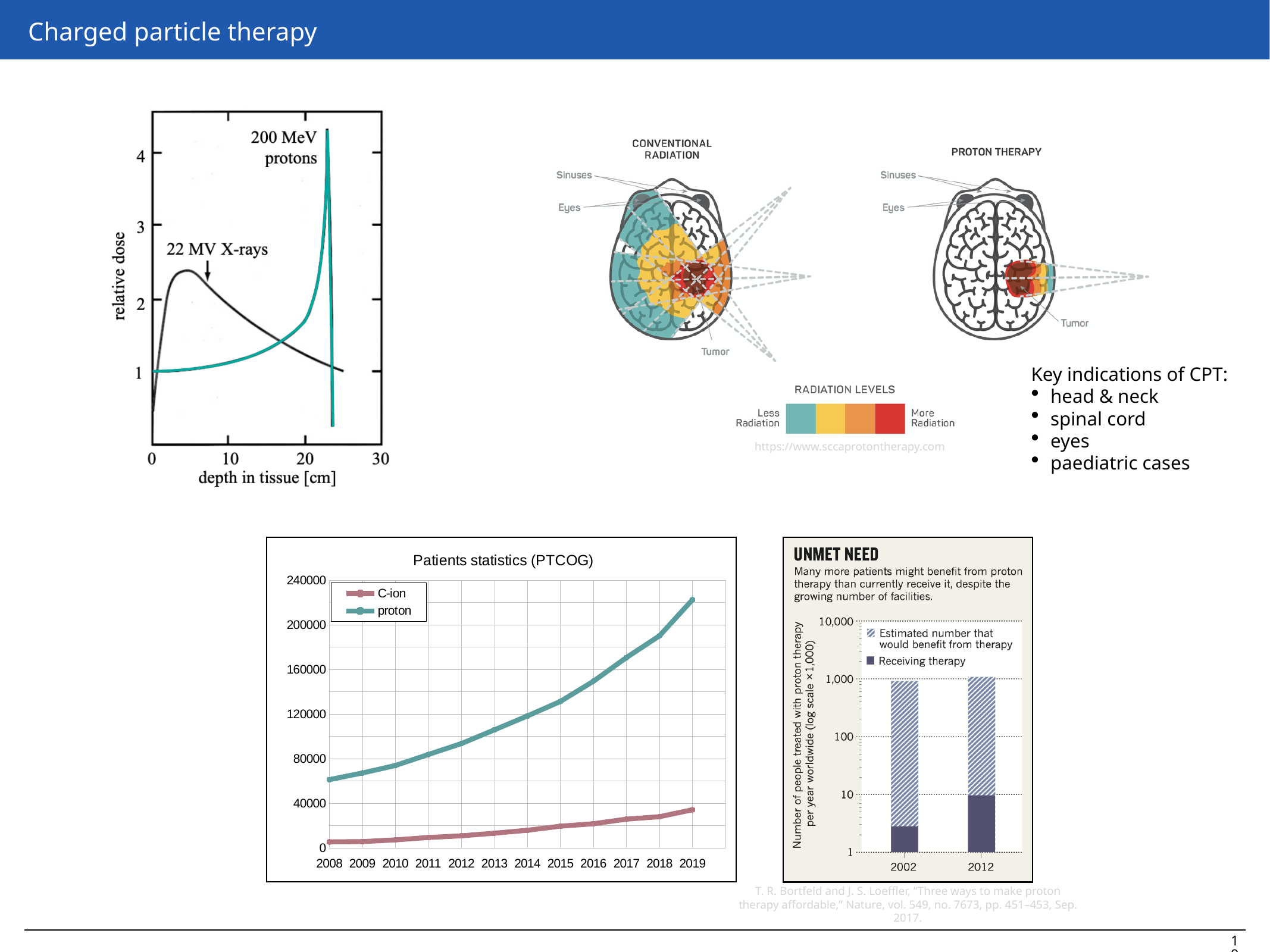
In the 'Patients statistics (PTCOG)' chart, how many years are shown on the x axis? 12 In the 'Patients statistics (PTCOG)' chart, is the C-ion value for 2019 greater or less than 40000? less In the 'Patients statistics (PTCOG)' chart, is the proton value for 2019 greater or less than 200000? greater In the 'Patients statistics (PTCOG)' chart, is the proton value for 2008 greater or less than 80000? less How many series does the legend of the 'Patients statistics (PTCOG)' chart list? 2 In the 'Patients statistics (PTCOG)' chart, do the proton values rise or fall from 2008 to 2019? rise In the 'Patients statistics (PTCOG)' chart, which series has the higher values throughout, C-ion or proton? proton In the 'UNMET NEED' chart, how many years are shown on the x axis? 2 What kind of chart is the 'Patients statistics (PTCOG)' chart? line chart In the 'Patients statistics (PTCOG)' chart, which year has the highest proton value? 2019